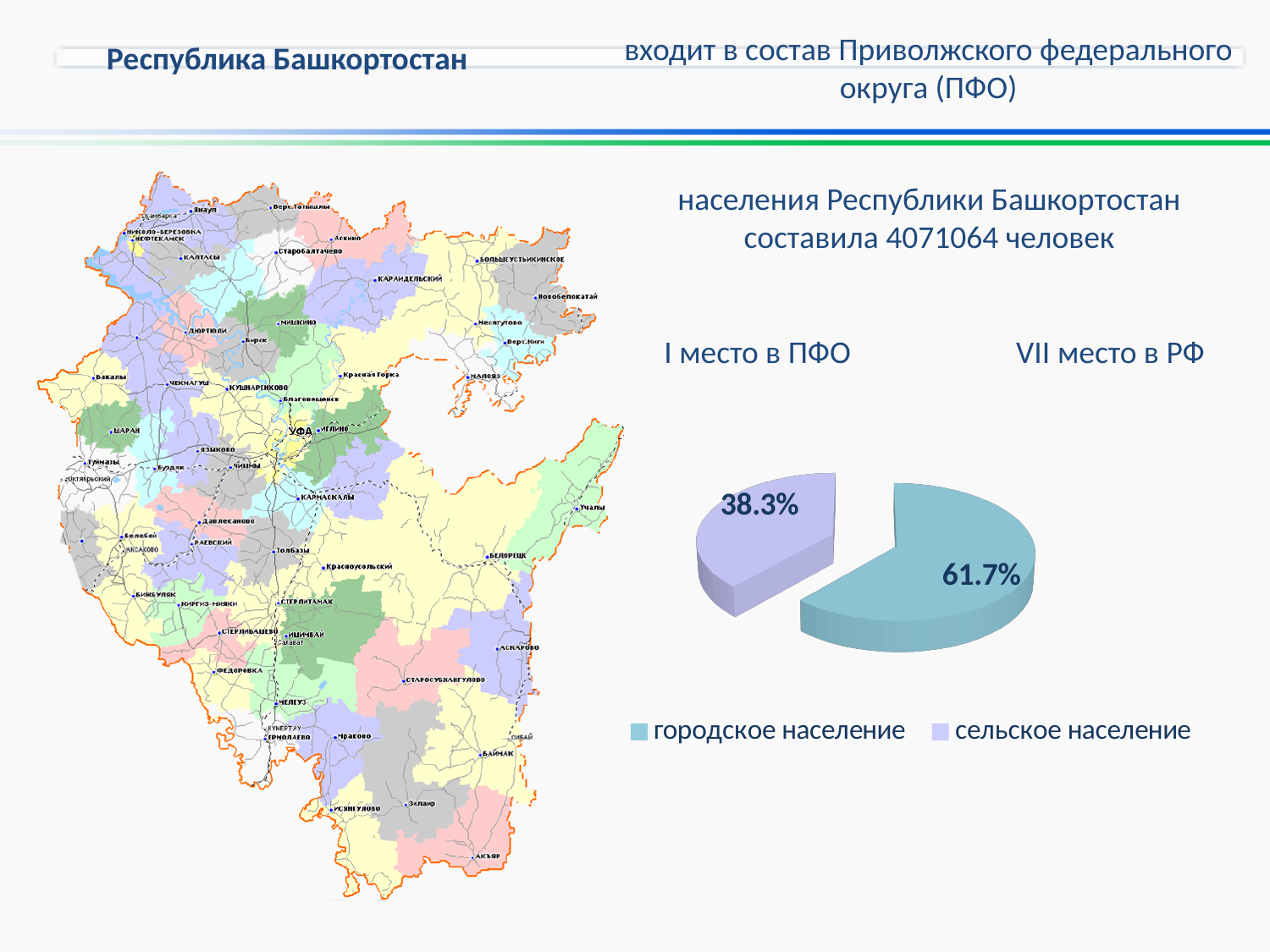
Which slice of the pie chart is the largest? городское население How many entries does the pie chart legend list? 2 What share of the pie chart is labelled сельское население? 38.3% What colour is the сельское население slice in the pie chart? light purple What kind of chart is shown on the right side of the slide? pie chart Which slice of the pie chart is the smallest? сельское население Which is larger in the pie chart: городское население or сельское население? городское население What share of the pie chart is labelled городское население? 61.7% What is the difference in percentage points between the городское население and сельское население slices? 23.4 How many slices does the pie chart have? 2 What colour is the городское население slice in the pie chart? teal blue